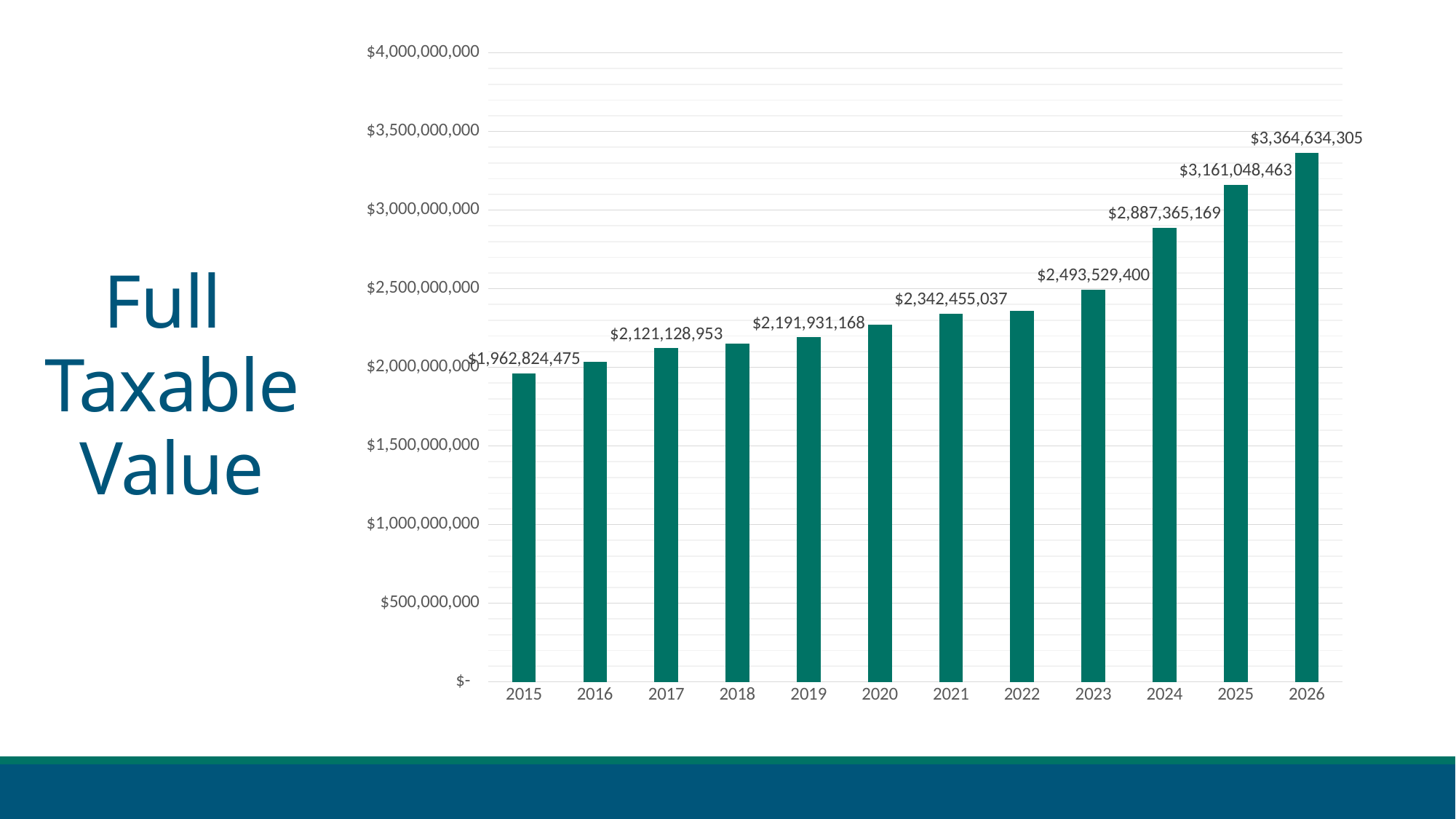
What value is labelled on the bar for 2024? $2,887,365,169 Which year has the highest full taxable value? 2026 Is the value for 2022 greater or less than $2,500,000,000? less Do the values rise or fall from 2015 to 2026? rise Which year has the lowest full taxable value? 2015 What is the difference between the 2026 and 2025 values? $203,585,842 What is the full taxable value shown for 2015? $1,962,824,475 What is the difference between the 2024 and 2023 values? $393,835,769 Which is larger, the value for 2019 or the value for 2023? 2023 What is the full taxable value shown for 2026? $3,364,634,305 What value is labelled on the bar for 2021? $2,342,455,037 How many years are shown on the x axis? 12